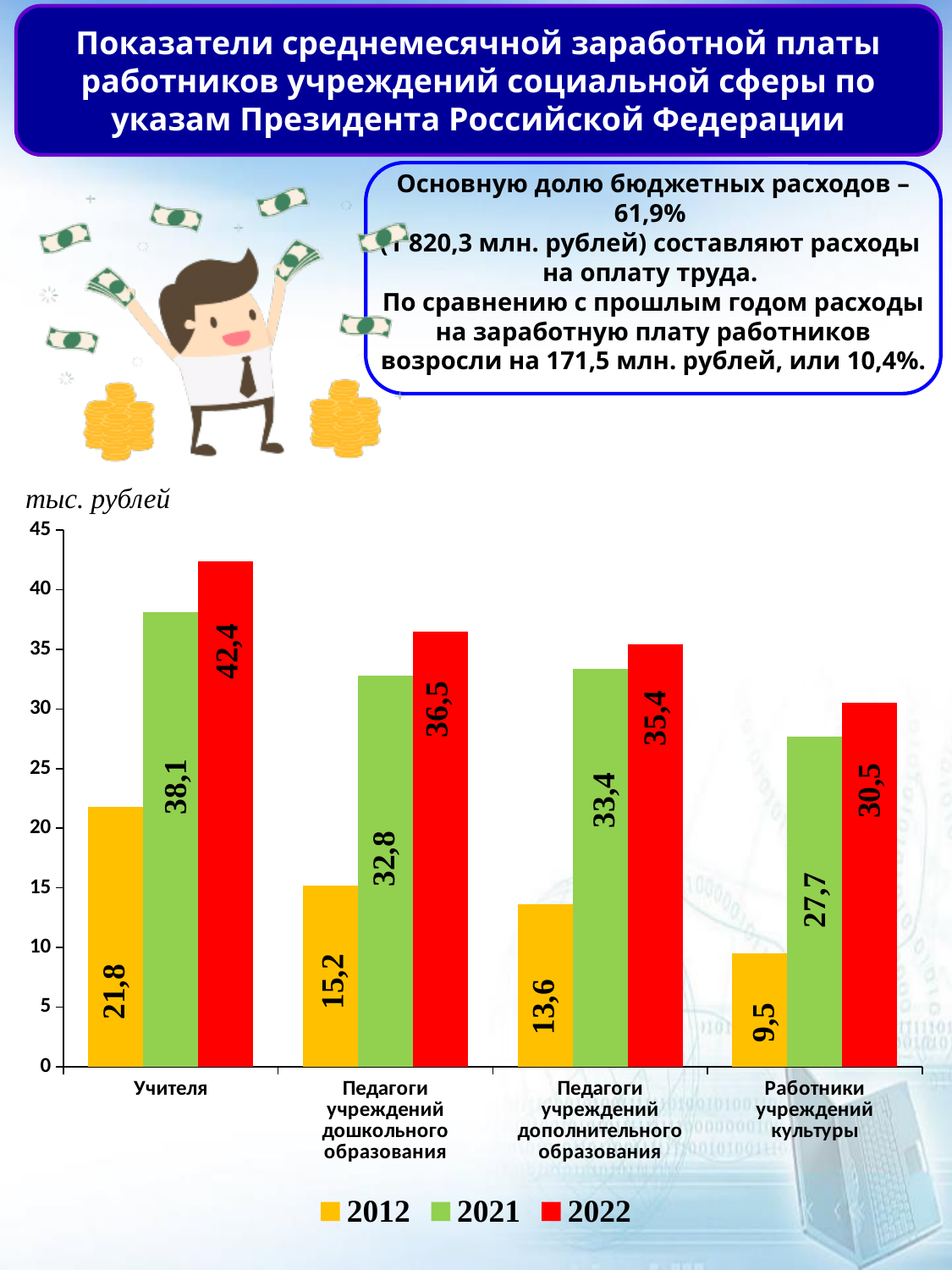
What unit is indicated above the chart's vertical axis? тыс. рублей How many categories are shown on the x axis of the chart? 4 What is the 2021 value for Педагоги учреждений дополнительного образования? 33,4 What is the difference between the 2022 and 2021 values for Педагоги учреждений дошкольного образования? 3,7 Which is larger: the 2021 value for Педагоги учреждений дошкольного образования or the 2021 value for Педагоги учреждений дополнительного образования? Педагоги учреждений дополнительного образования What is the 2012 value for Работники учреждений культуры? 9,5 Which category has the highest 2022 value? Учителя How many series does the legend list? 3 Which category has the lowest 2012 value? Работники учреждений культуры What is the 2022 value for Учителя? 42,4 What is the difference between the 2022 and 2012 values for Учителя? 20,6 What kind of chart is shown on the slide? Bar chart